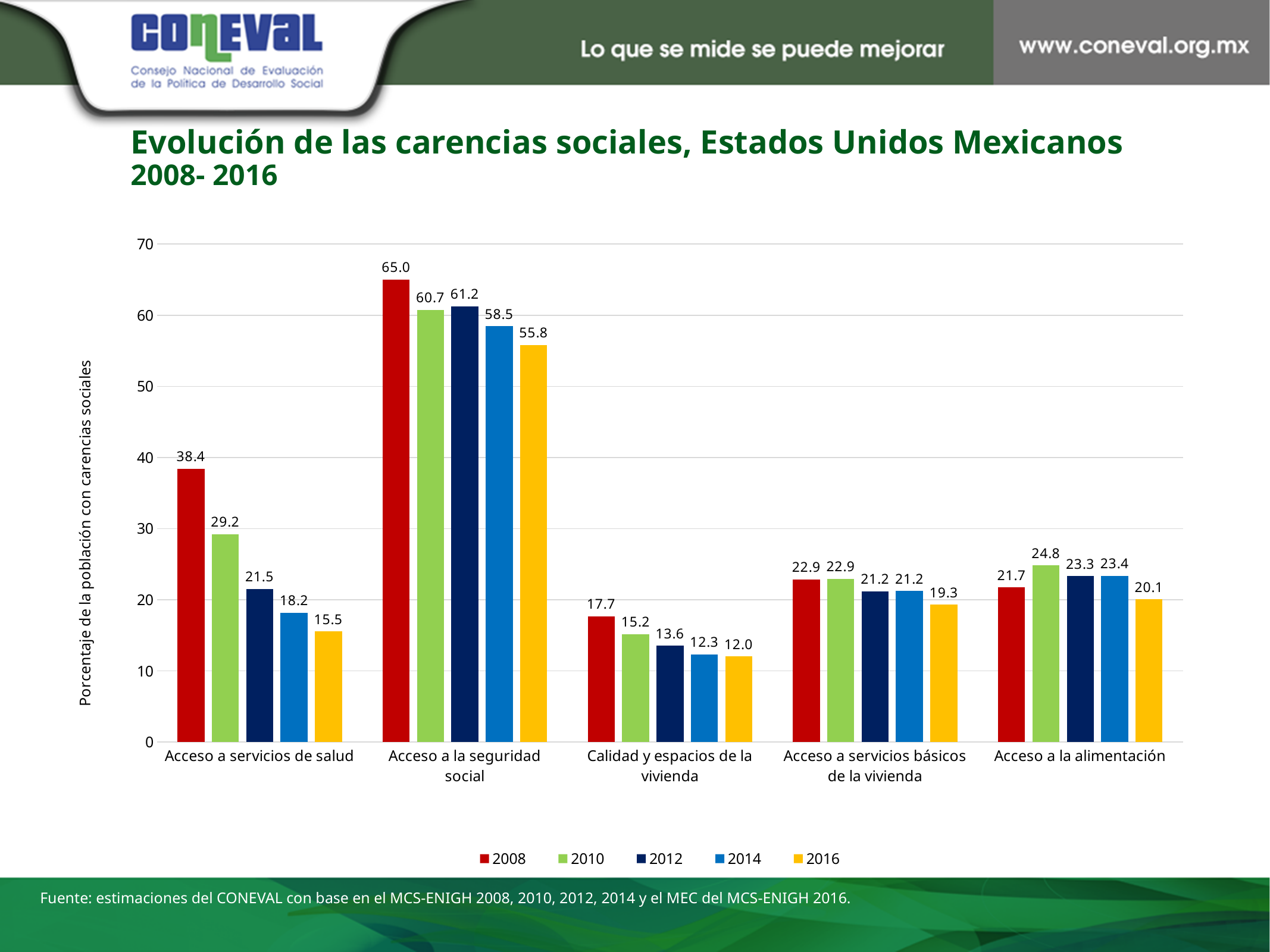
How many series does the legend list? 5 What is the label of the y axis? Porcentaje de la población con carencias sociales Which is larger for Acceso a la alimentación: the 2010 value or the 2016 value? 2010 What is the value for Acceso a la seguridad social in 2016? 55.8 What is the value for Calidad y espacios de la vivienda in 2012? 13.6 What is the value for Acceso a servicios de salud in 2008? 38.4 Which category has the lowest value in 2016? Calidad y espacios de la vivienda Which category has the highest value in 2008? Acceso a la seguridad social How many categories are shown on the x axis? 5 What kind of chart is shown on the slide? bar chart Do the values for Acceso a servicios de salud rise or fall from 2008 to 2016? fall What is the difference between the 2008 and 2016 values for Acceso a servicios de salud? 22.9